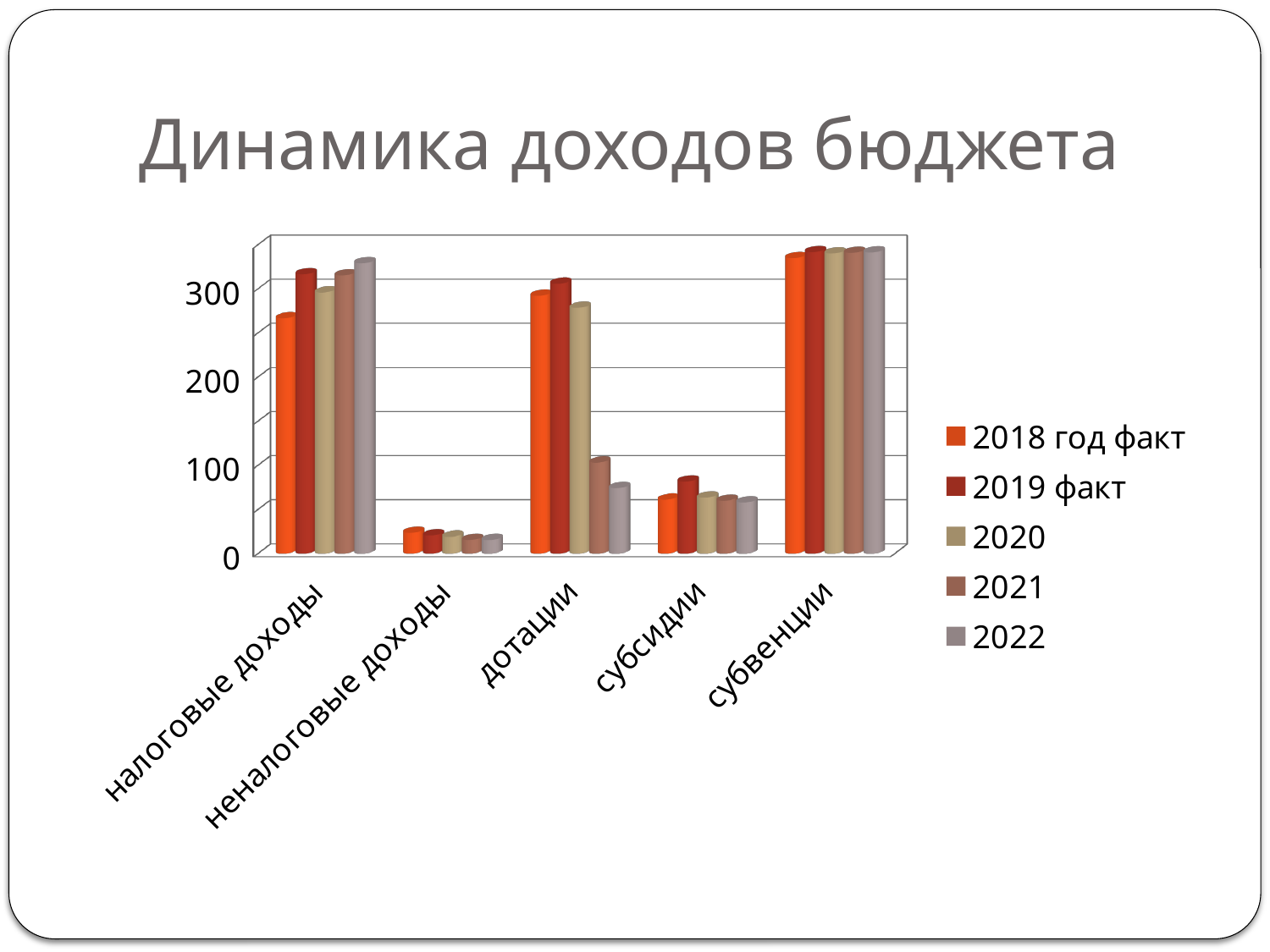
What is the title of the chart? Динамика доходов бюджета Is the value for налоговые доходы in 2018 год факт greater or less than 200? greater What kind of chart is shown on the slide? bar chart Which series is listed first in the legend? 2018 год факт How many series does the legend list? 5 For дотации, which is larger: the value for 2018 год факт or the value for 2022? 2018 год факт Which category has the lowest value for 2018 год факт? неналоговые доходы Which category has the highest value for 2018 год факт? субвенции Is the value for субвенции in 2018 год факт greater or less than 300? greater How many categories are shown on the x axis of the chart? 5 Is the value for субсидии in 2019 факт greater or less than 100? less